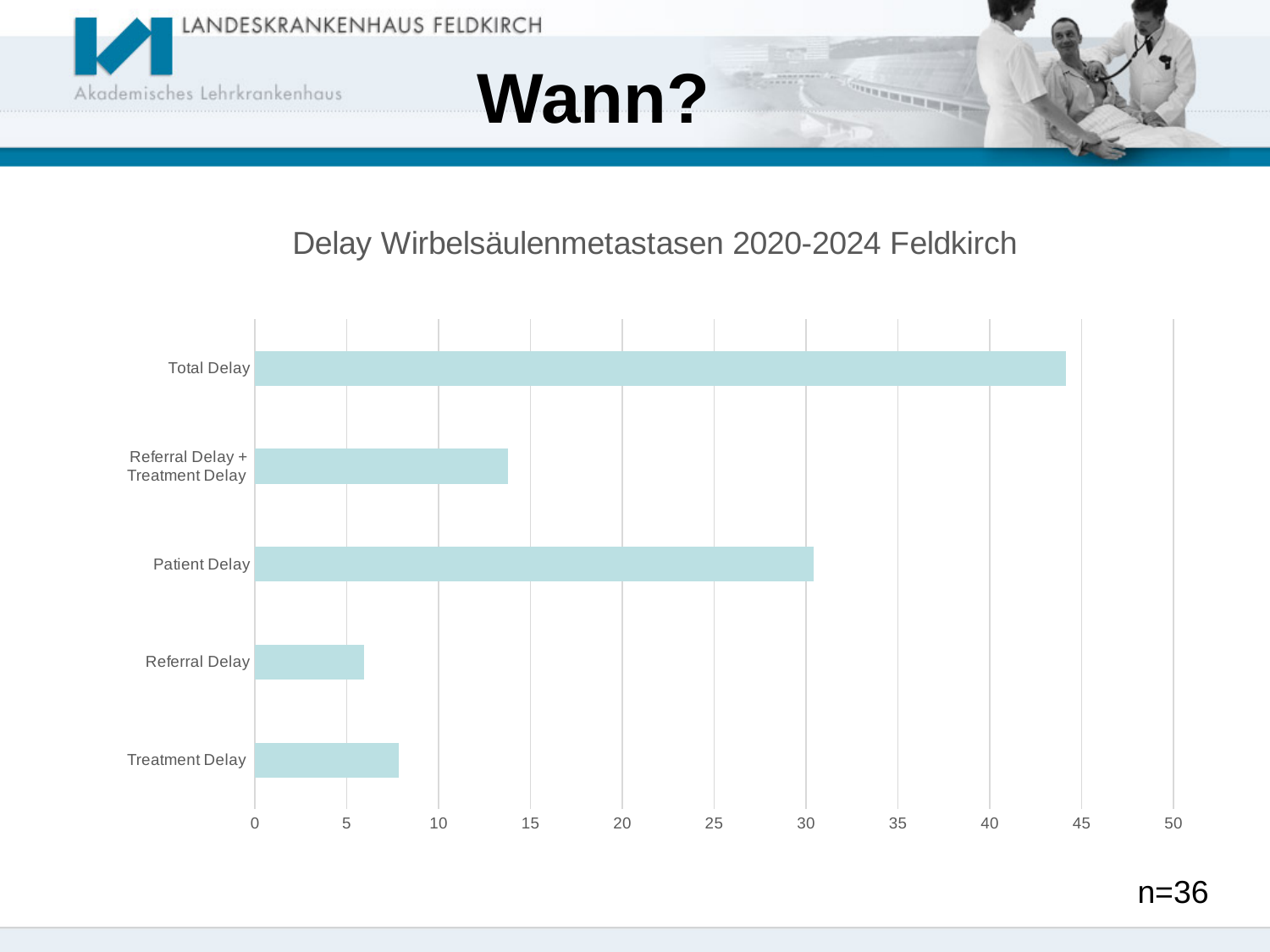
Is the value for Total Delay greater or less than 40? greater Is the value for Treatment Delay greater or less than 5? greater Which is larger, Patient Delay or Referral Delay + Treatment Delay? Patient Delay What kind of chart is shown on the slide? bar chart What is the title of the chart? Delay Wirbelsäulenmetastasen 2020-2024 Feldkirch Which category has the lowest value? Referral Delay Is the value for Referral Delay greater or less than 10? less Which is larger, Treatment Delay or Referral Delay? Treatment Delay Which category has the highest value? Total Delay How many categories are plotted in the chart? 5